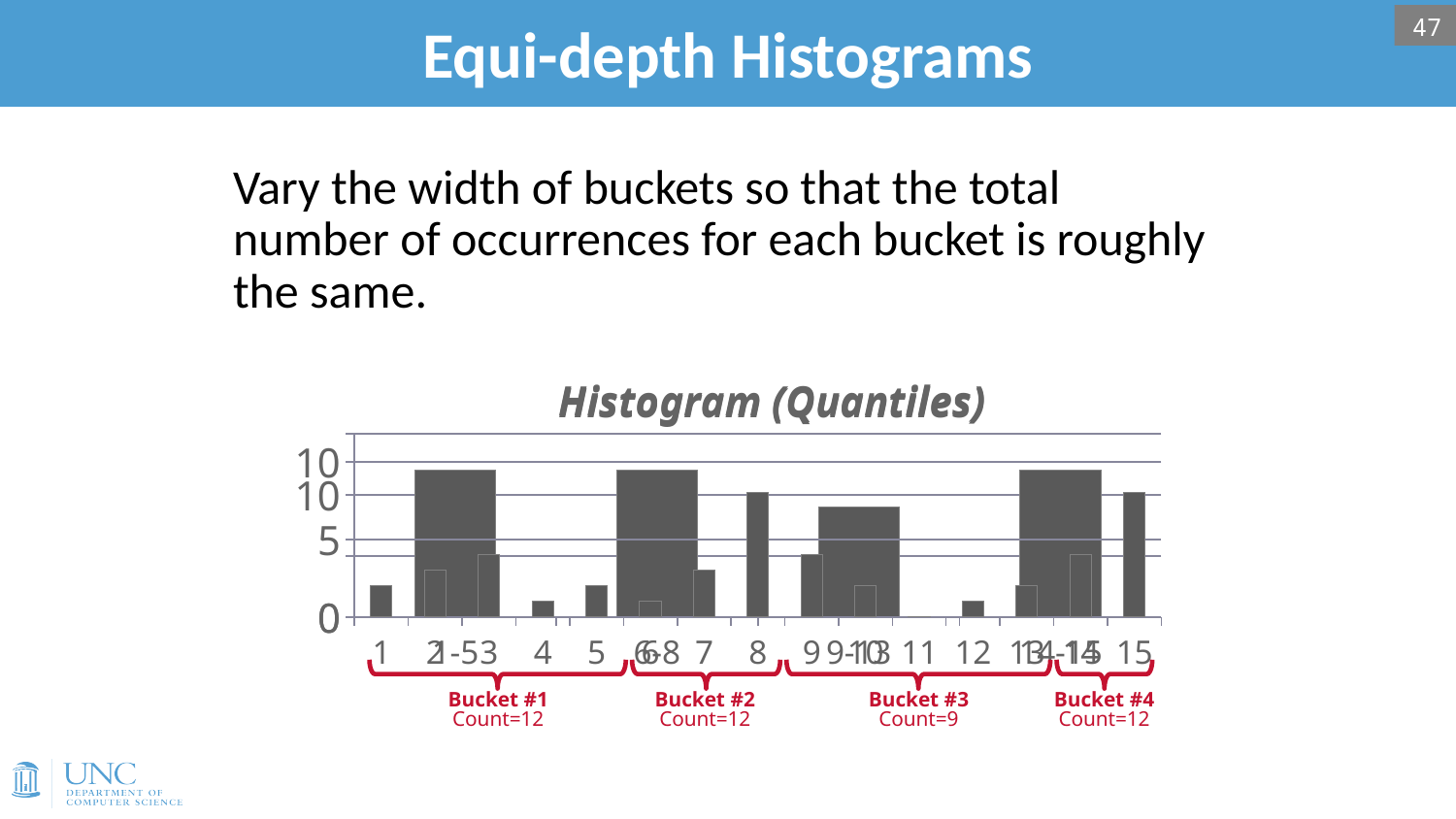
How many buckets are marked below the chart? 4 What kind of chart is shown on the slide? bar chart Which is larger, the value for 8 or the value for 4? 8 Which has a larger count, Bucket #4 or Bucket #3? Bucket #4 Is the value for 8 greater or less than 5? greater Is the value for 12 greater or less than 5? less What is the difference between the count of Bucket #2 and the count of Bucket #3? 3 What is the count for Bucket #1? Count=12 Which bucket has the lowest count? Bucket #3 What is the count for Bucket #3? Count=9 What is the title of the chart? Histogram (Quantiles)